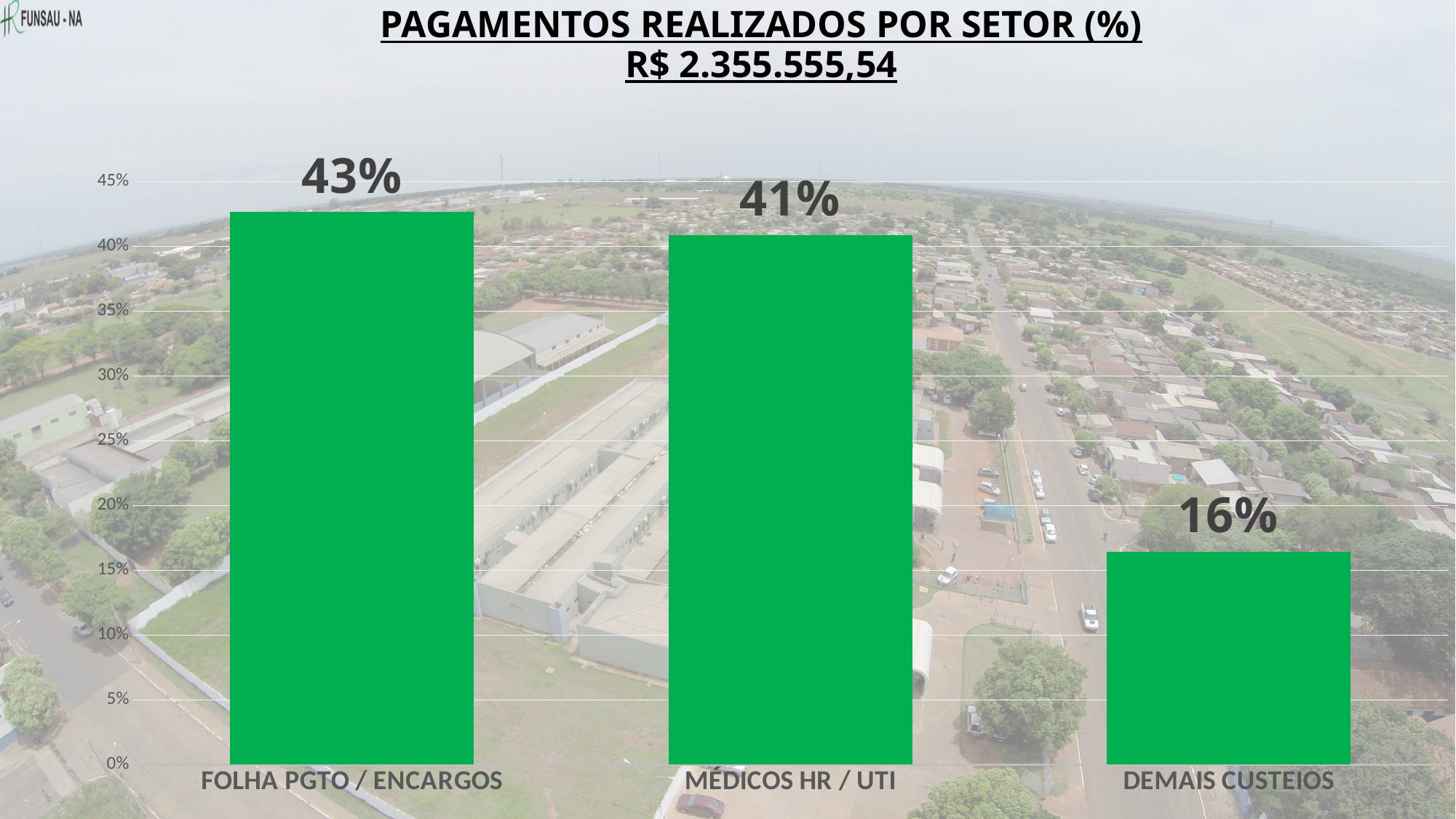
What total amount in R$ is shown in the chart title? R$ 2.355.555,54 What is the value for DEMAIS CUSTEIOS? 16% How many categories are shown in the chart? 3 What is the difference between the values for FOLHA PGTO / ENCARGOS and DEMAIS CUSTEIOS? 27% What is the value for MÉDICOS HR / UTI? 41% What is the difference between the values for MÉDICOS HR / UTI and DEMAIS CUSTEIOS? 25% Which is larger, the value for MÉDICOS HR / UTI or the value for DEMAIS CUSTEIOS? MÉDICOS HR / UTI What kind of chart is shown on the slide? bar chart Is the value for DEMAIS CUSTEIOS greater or less than 20%? less What is the value for FOLHA PGTO / ENCARGOS? 43% Which category has the highest value? FOLHA PGTO / ENCARGOS Which category has the lowest value? DEMAIS CUSTEIOS